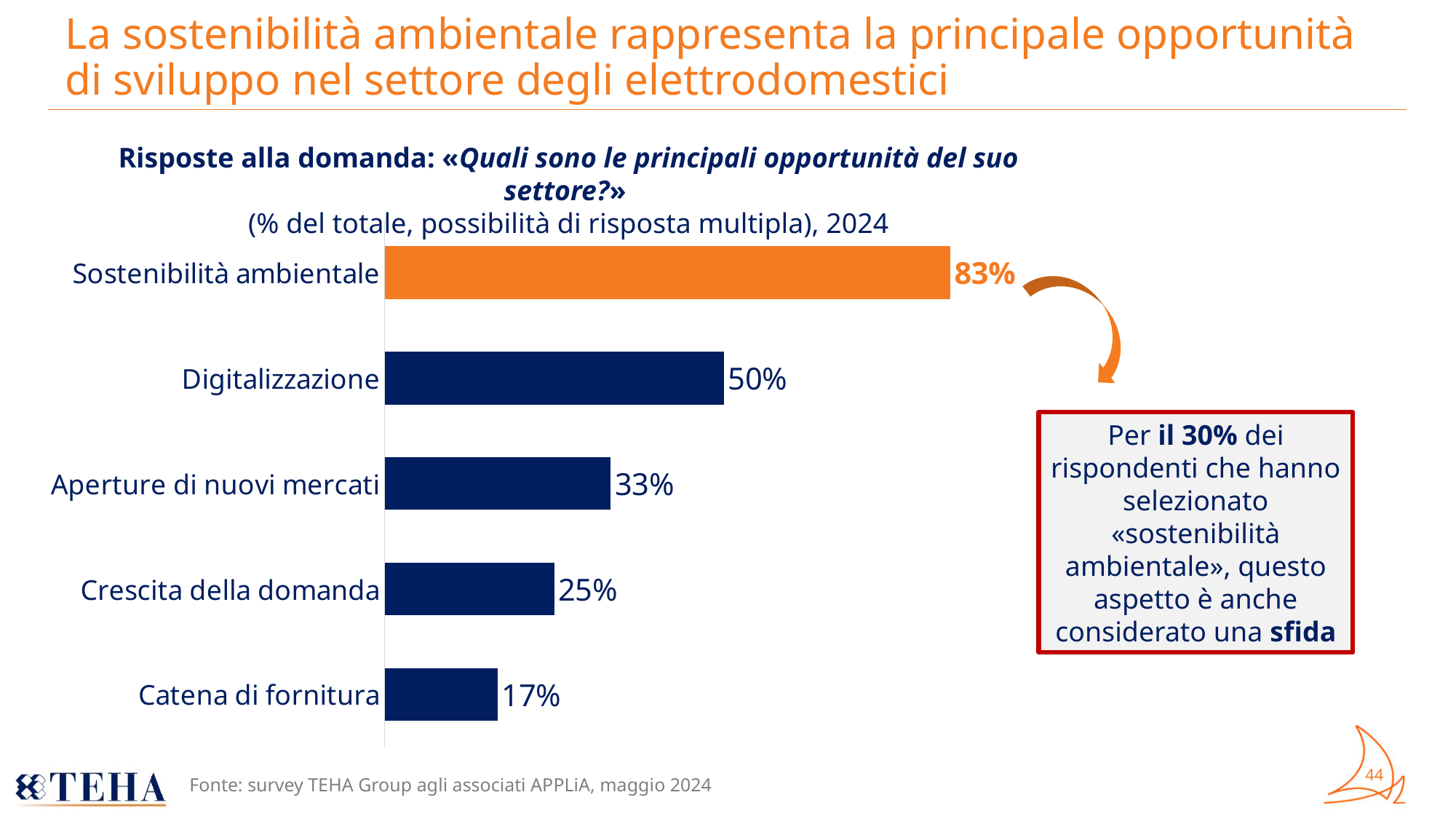
Which bar is coloured orange rather than dark blue? Sostenibilità ambientale What is the difference between the values for Crescita della domanda and Catena di fornitura? 8 percentage points How many categories are shown in the chart? 5 Which category has the lowest value? Catena di fornitura Which category has the highest value? Sostenibilità ambientale What kind of chart is shown on the slide? Bar chart What is the difference between the values for Sostenibilità ambientale and Digitalizzazione? 33 percentage points Which is larger, the value for Aperture di nuovi mercati or the value for Crescita della domanda? Aperture di nuovi mercati What is the value for Digitalizzazione? 50% What is the value for Aperture di nuovi mercati? 33% What is the value for Sostenibilità ambientale? 83% What is the value for Catena di fornitura? 17%